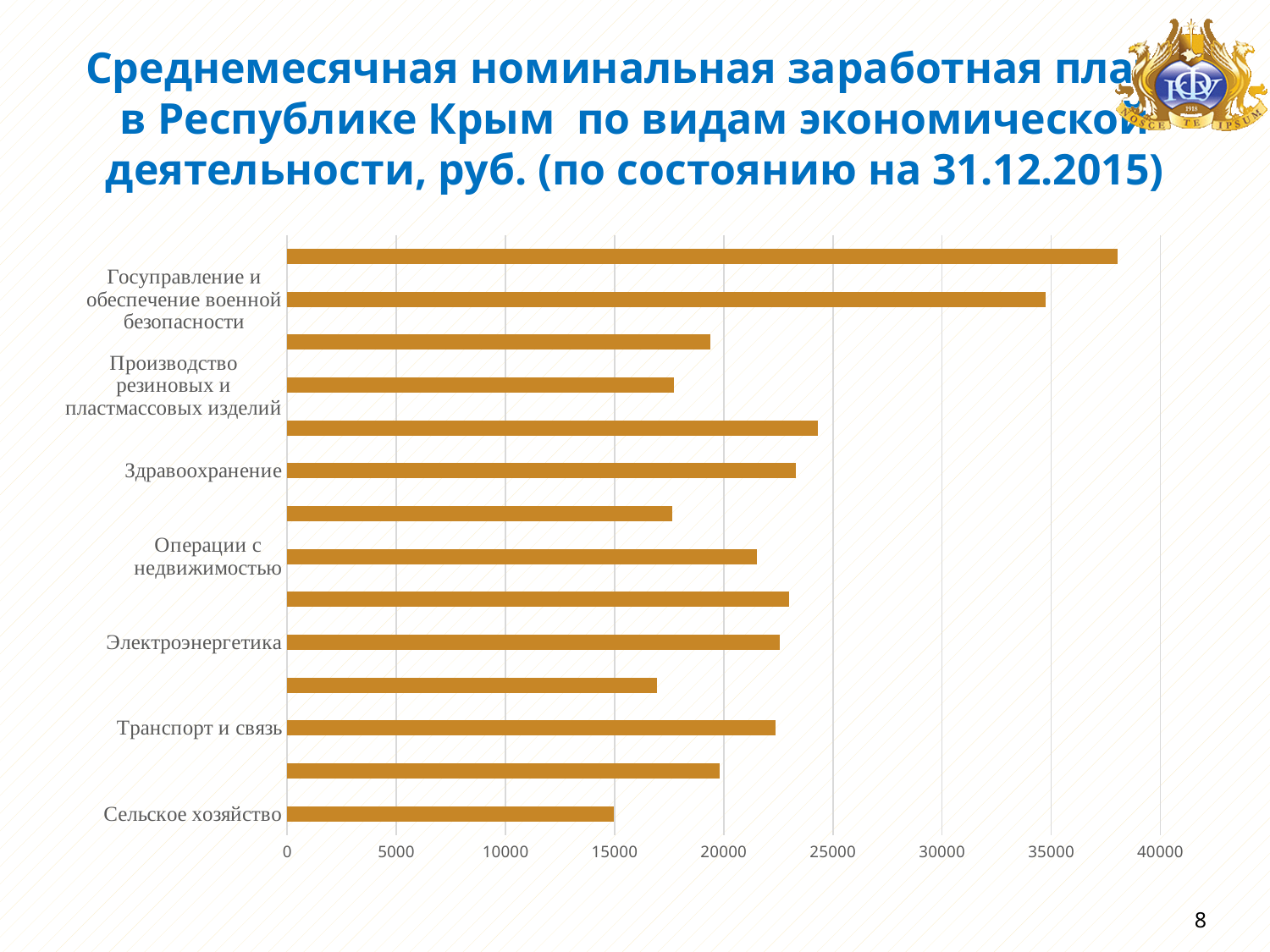
Which has the larger value, Здравоохранение or Производство резиновых и пластмассовых изделий? Здравоохранение What is the highest value shown on the horizontal axis of the chart? 40000 Which has the larger value, Госуправление и обеспечение военной безопасности or Сельское хозяйство? Госуправление и обеспечение военной безопасности What kind of chart is shown on the slide? bar chart Is the value for Транспорт и связь greater or less than 25000? less Which category has the lowest value in the chart? Сельское хозяйство How many bars are plotted in the chart? 14 Is the value for Производство резиновых и пластмассовых изделий greater or less than 20000? less Is the value for Электроэнергетика greater or less than 20000? greater